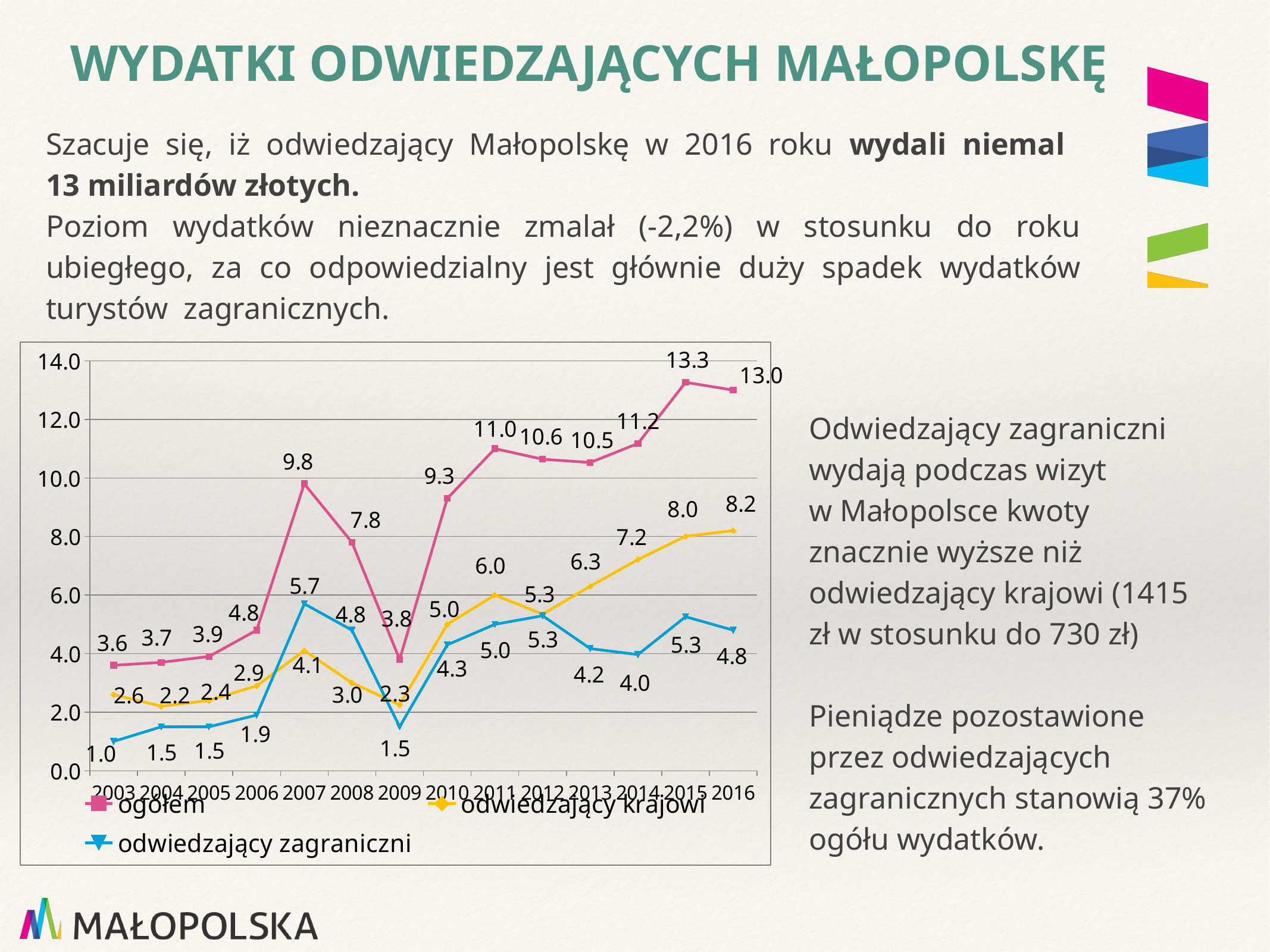
Does the 'odwiedzający krajowi' series rise or fall from 2013 to 2016? rise What is the value of the 'ogółem' series in 2009? 3.8 In 2007, which series has the larger value: 'odwiedzający krajowi' or 'odwiedzający zagraniczni'? odwiedzający zagraniczni What is the difference between the 'ogółem' values for 2015 and 2016? 0.3 In which year is the 'odwiedzający zagraniczni' series at its lowest value? 2003 How many series does the chart legend list? 3 What is the value of the 'ogółem' series in 2016? 13.0 What is the value of the 'odwiedzający krajowi' series in 2014? 7.2 In which year does the 'ogółem' series reach its highest value? 2015 What type of chart is shown on the slide? line chart What is the value of the 'odwiedzający zagraniczni' series in 2007? 5.7 How many years are shown on the x axis of the chart? 14